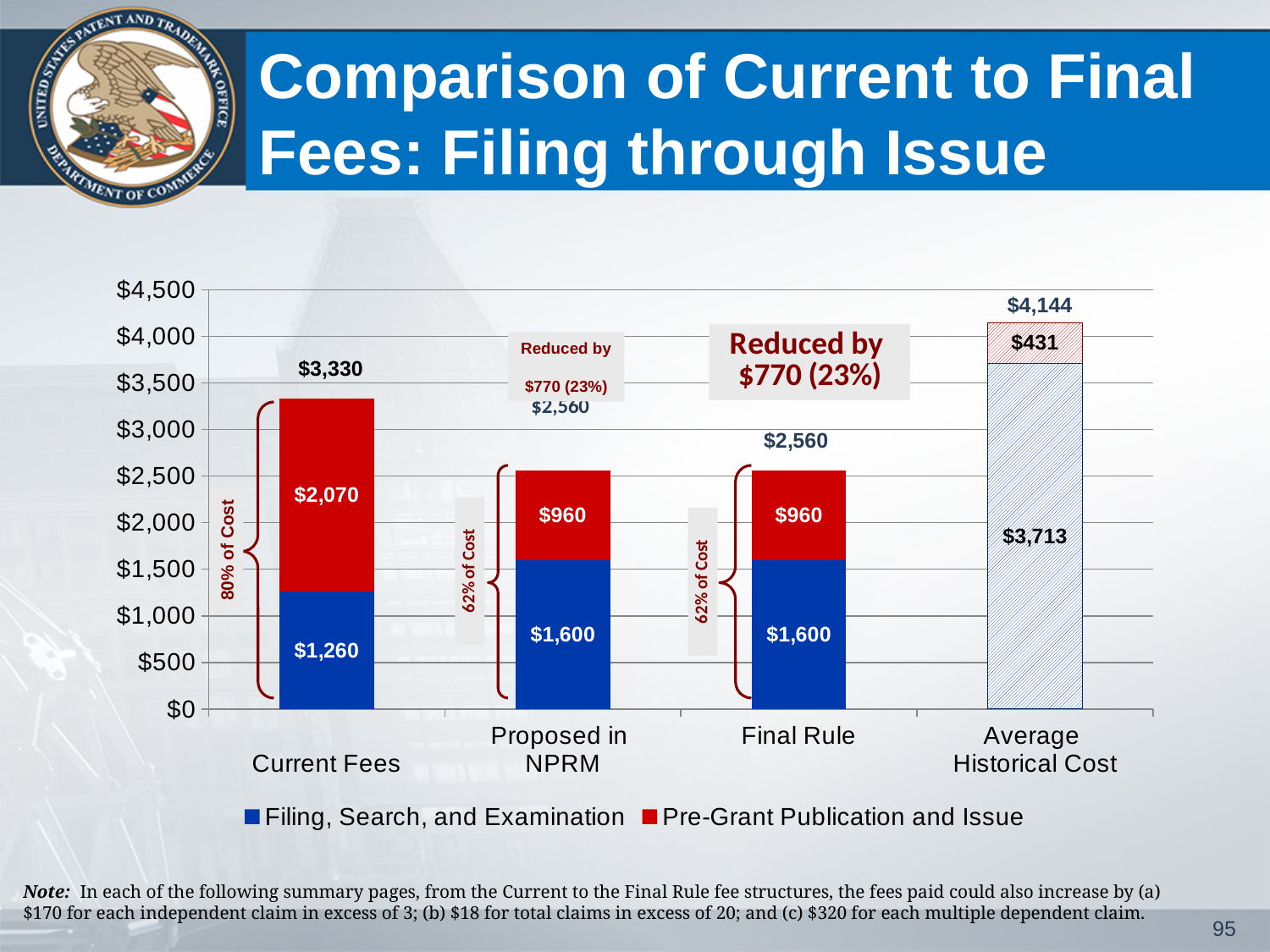
What is the Filing, Search, and Examination value for Current Fees? $1,260 What type of chart is shown on the slide? Stacked bar chart What is the total of the Current Fees bar? $3,330 How many categories are shown along the x axis? 4 Which is larger, the Pre-Grant Publication and Issue value for Current Fees or for Proposed in NPRM? Current Fees Which category has the highest total bar? Average Historical Cost How many series does the legend list? 2 What is the total of the Average Historical Cost bar? $4,144 What is the Pre-Grant Publication and Issue value for Current Fees? $2,070 What is the Filing, Search, and Examination value for Final Rule? $1,600 What is the difference between the Current Fees total and the Final Rule total? $770 Which series is shown in red in the legend? Pre-Grant Publication and Issue